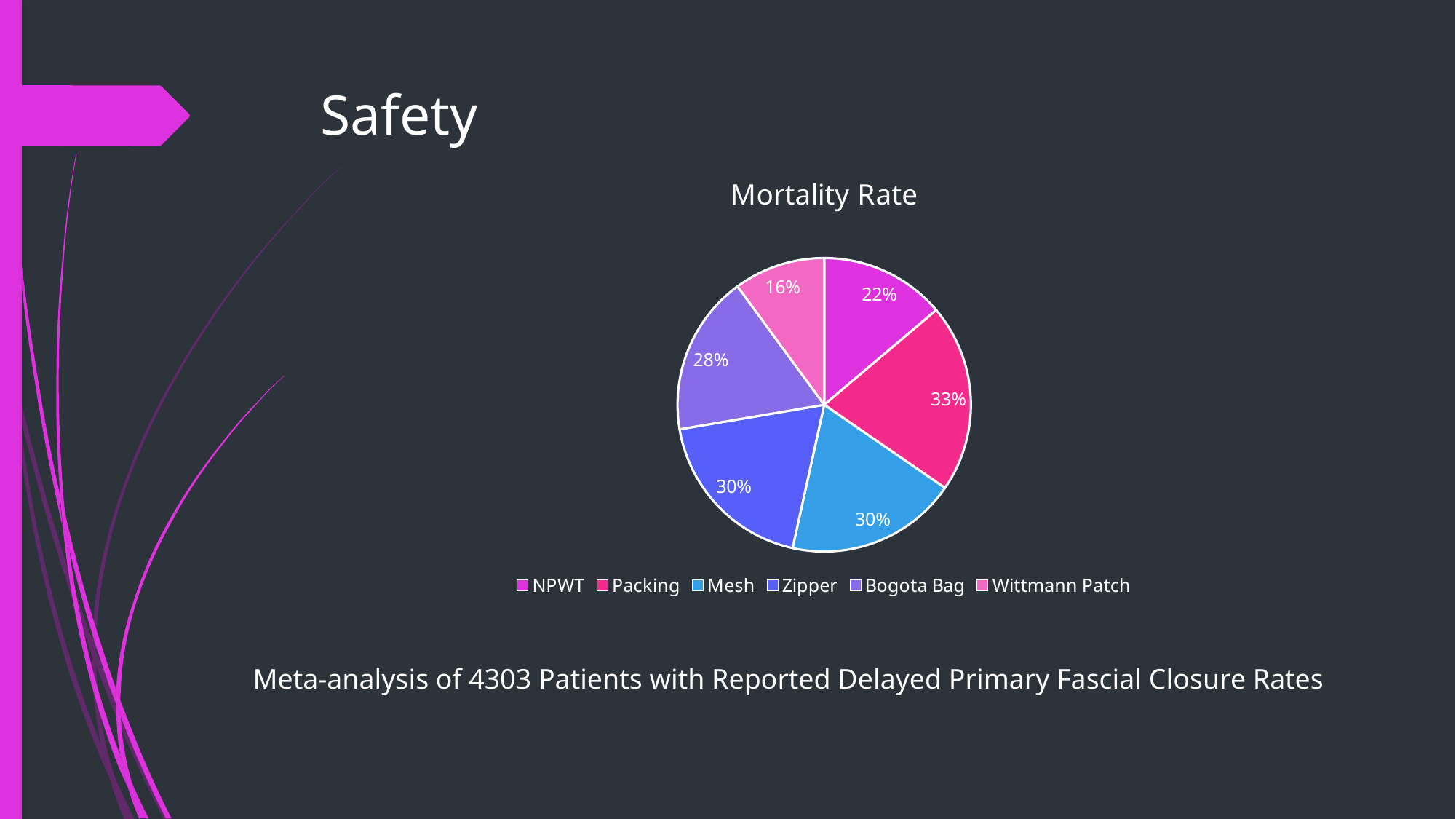
What is the mortality rate shown for Mesh? 30% What is the mortality rate shown for NPWT? 22% Which category has the highest mortality rate? Packing Which category has the lowest mortality rate? Wittmann Patch What is the mortality rate shown for Wittmann Patch? 16% What is the title of the chart? Mortality Rate Which has a higher mortality rate, Bogota Bag or Wittmann Patch? Bogota Bag What is the difference between the mortality rates for Packing and NPWT? 11% What is the mortality rate shown for Packing? 33% How many categories are shown in the pie chart? 6 What type of chart is shown on the slide? pie chart What is the mortality rate shown for Bogota Bag? 28%